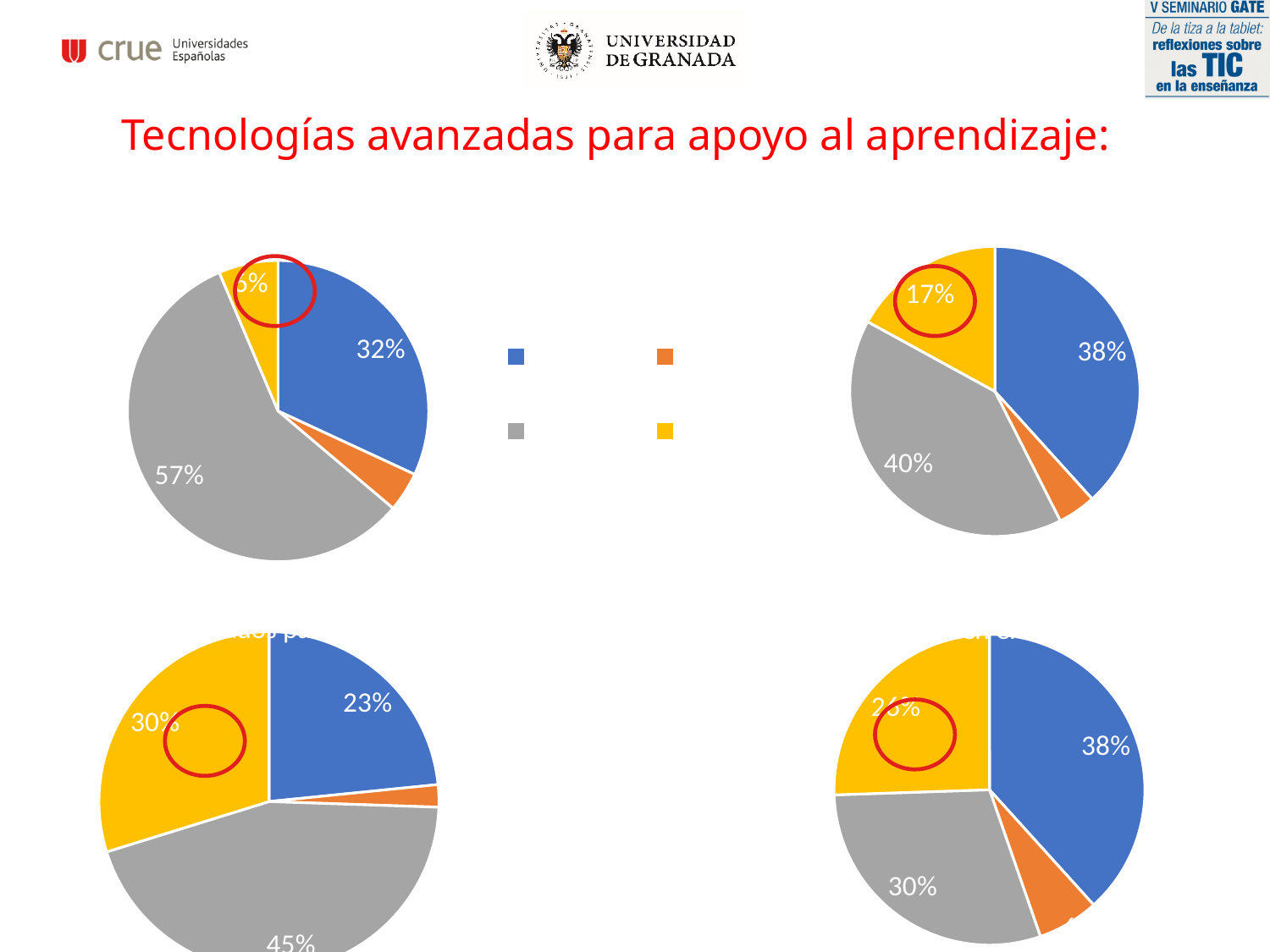
In the top-right pie chart, what percentage does the yellow slice represent? 17% In the top-right pie chart, what is the difference between the grey slice and the blue slice? 2% In the bottom-left pie chart, which is larger, the blue slice or the yellow slice? Yellow slice How many pie charts are on the slide? 4 In the top-left pie chart, which colour slice is the largest? Grey In the bottom-left pie chart, what is the difference between the grey slice and the blue slice? 22% In the top-left pie chart, what percentage does the blue slice represent? 32% In the bottom-right pie chart, which colour slice is the smallest? Orange In the top-left pie chart, what percentage does the grey slice represent? 57% In the bottom-right pie chart, what percentage does the blue slice represent? 38% In the bottom-left pie chart, what percentage does the grey slice represent? 45% What kind of charts are shown on the slide? Pie charts